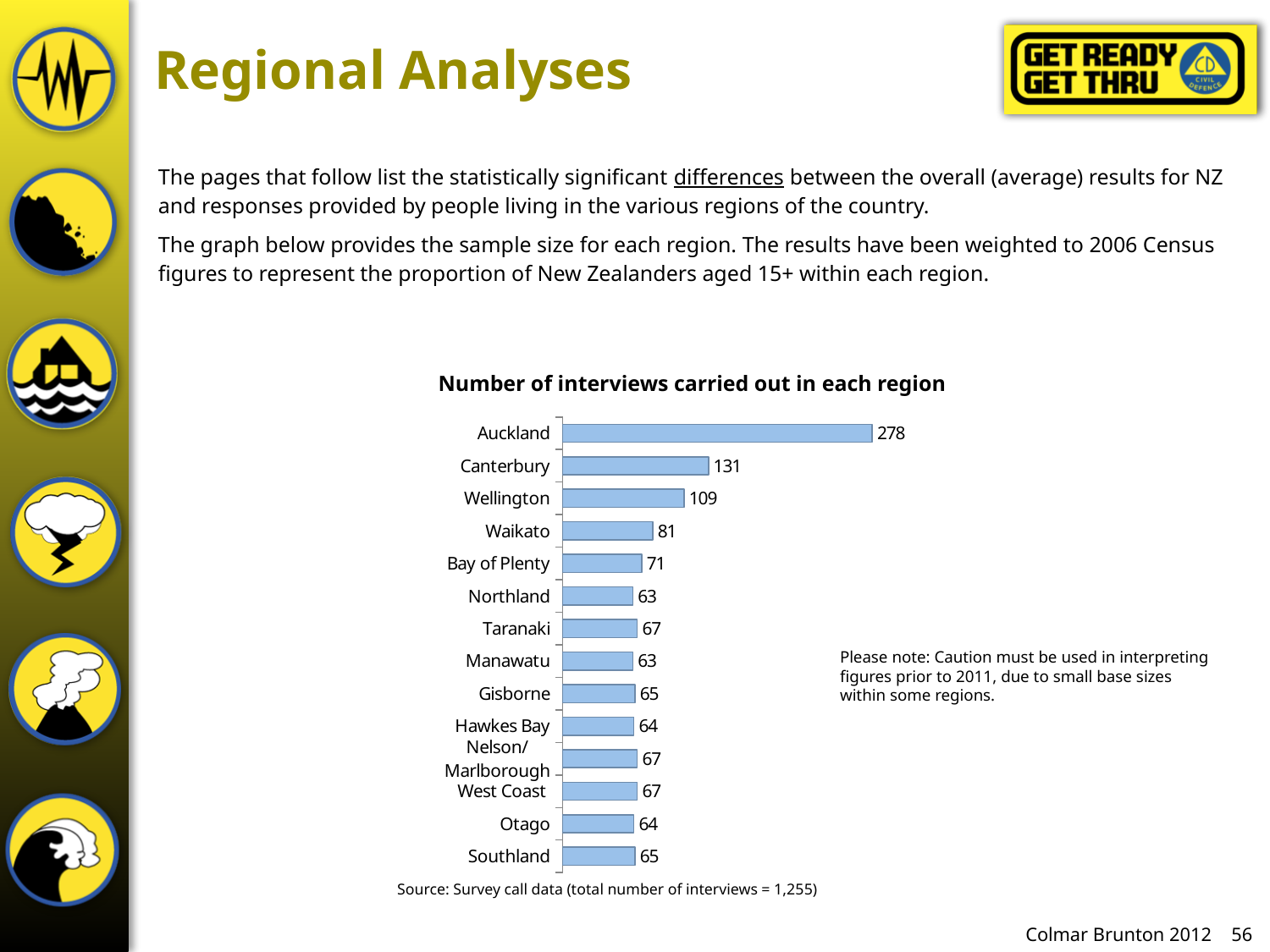
How many interviews were carried out in Wellington? 109 Which region had the highest number of interviews? Auckland Which region had more interviews, Waikato or Bay of Plenty? Waikato What is the title of the chart? Number of interviews carried out in each region What is the number of interviews carried out in Auckland? 278 What is the difference between the number of interviews in Auckland and Canterbury? 147 According to the source note below the chart, what is the total number of interviews? 1,255 What is the value shown for Bay of Plenty? 71 What is the difference between the number of interviews in Waikato and Northland? 18 What type of chart is used to show the number of interviews in each region? Bar chart Which region had more interviews, Canterbury or Wellington? Canterbury How many regions are shown in the chart? 14